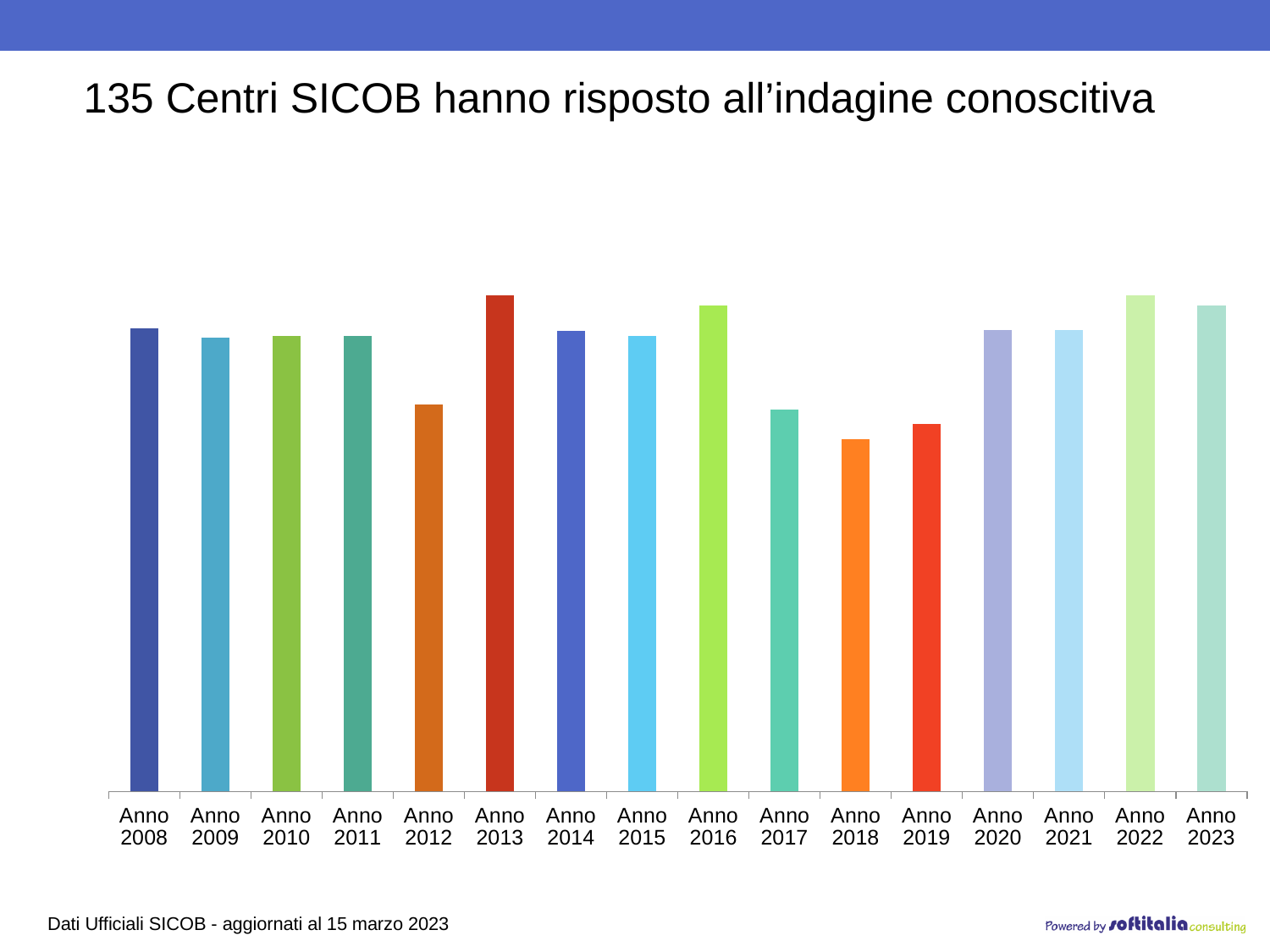
Which is larger, the bar for Anno 2020 or the bar for Anno 2022? Anno 2022 Which year has the lowest bar in the chart? Anno 2018 What kind of chart is shown on the slide? bar chart Which is larger, the bar for Anno 2008 or the bar for Anno 2018? Anno 2008 Do the bars rise or fall from Anno 2018 to Anno 2022? rise What is the first year shown on the x axis of the chart? Anno 2008 Which is larger, the bar for Anno 2016 or the bar for Anno 2017? Anno 2016 What is the title of the slide containing the chart? 135 Centri SICOB hanno risposto all'indagine conoscitiva Do the bars rise or fall from Anno 2016 to Anno 2018? fall How many years (categories) are shown on the x axis of the chart? 16